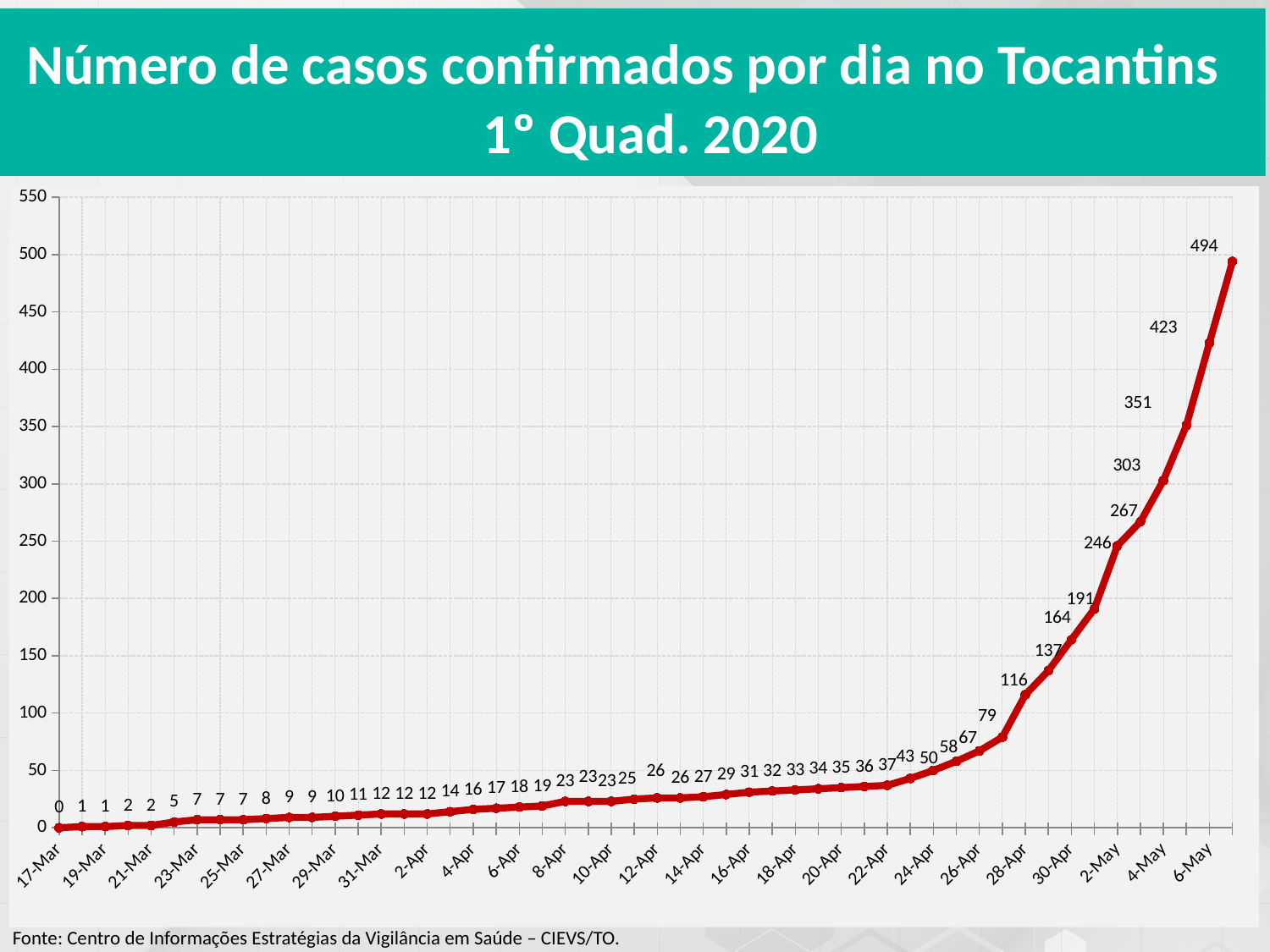
Do the values generally rise or fall along the x axis from 17-Mar to the last date? rise Is the value for 4-May greater or less than 250? greater What is the value at the first point, 17-Mar? 0 What is the number of confirmed cases on 2-May? 246 What is the difference between the values on 6-May and 4-May? 120 What is the number of confirmed cases on 30-Apr? 164 What is the title of the chart? Número de casos confirmados por dia no Tocantins 1° Quad. 2020 What is the number of confirmed cases on 28-Apr? 116 What is the number of confirmed cases on 6-May? 423 Which date has more confirmed cases, 28-Apr or 30-Apr? 30-Apr What type of chart is shown on the slide? line chart What is the highest value plotted on the chart? 494